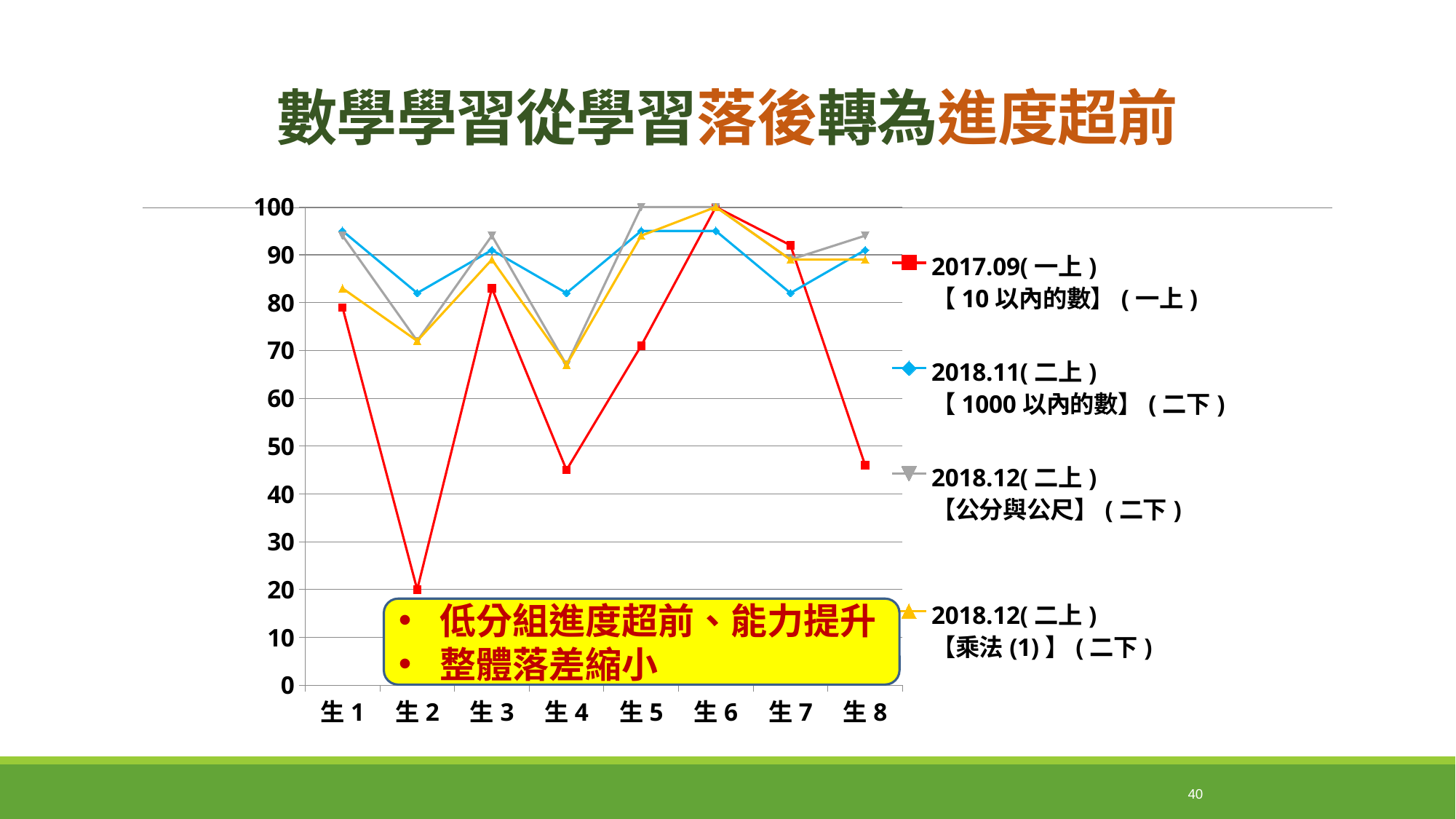
What is the value for 生6 in the 2017.09(一上) series? 100 Which student has the lowest value in the 2017.09(一上) series? 生2 How many series does the legend list? 4 Is the value for 生1 in the 2018.11(二上) series greater or less than 90? greater Which student has the highest value in the 2017.09(一上) series? 生6 Does the 2017.09(一上) series rise or fall from 生1 to 生2? fall What is the value for 生2 in the 2017.09(一上) series? 20 Is the value for 生4 in the 2017.09(一上) series greater or less than 50? less What kind of chart is shown on the slide? line chart How many students (categories) are plotted along the x axis? 8 Which series is drawn in red with square markers? 2017.09(一上)【10以內的數】(一上) For 生5, which series has the larger value: 2017.09(一上) or 2018.11(二上)? 2018.11(二上)